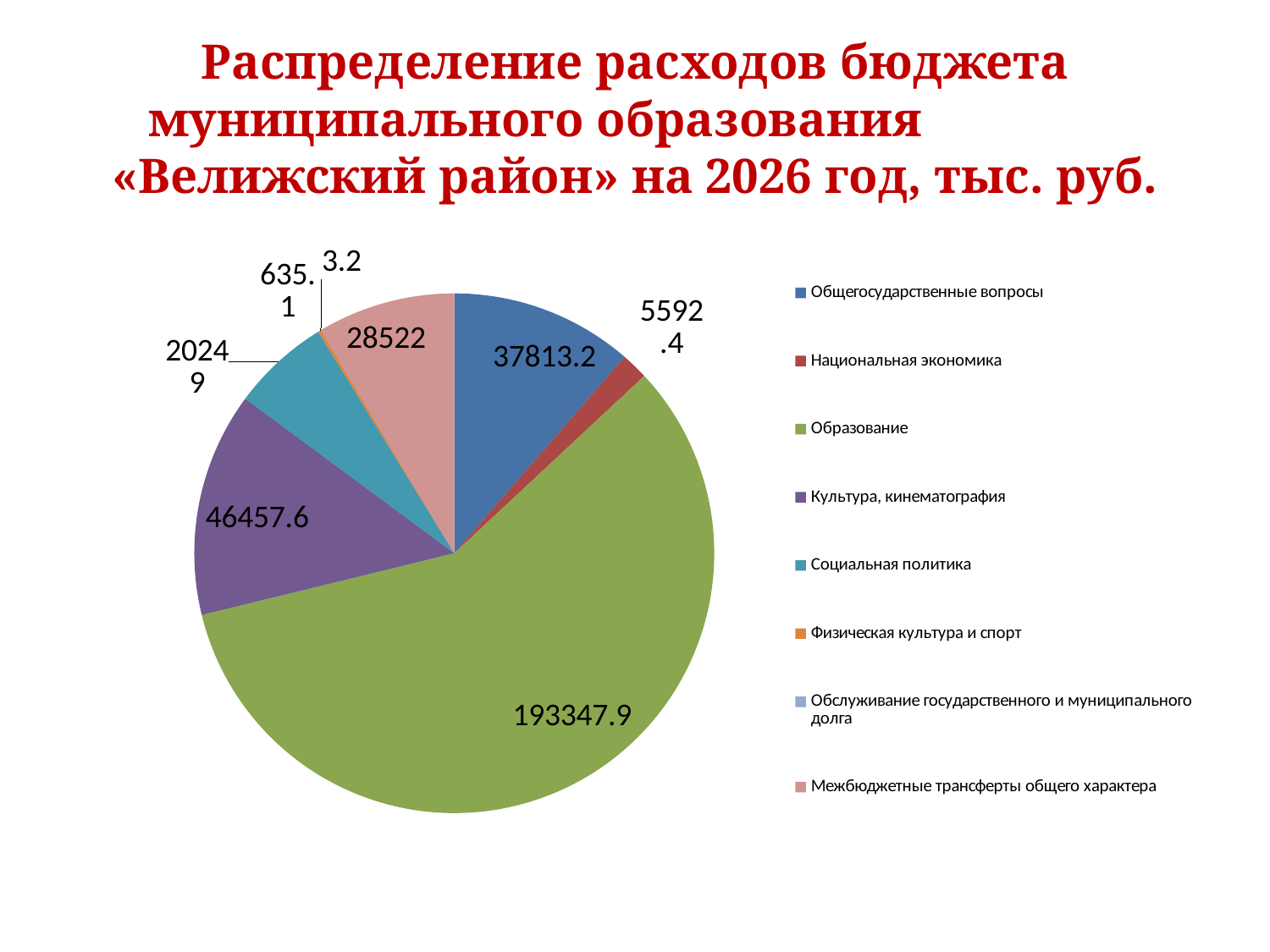
What colour is the slice for Образование? Green Which is larger: the value for Межбюджетные трансферты общего характера or the value for Социальная политика? Межбюджетные трансферты общего характера What is the value for Культура, кинематография? 46457.6 Which category has the largest slice of the pie? Образование What is the value for Межбюджетные трансферты общего характера? 28522 What is the value for Общегосударственные вопросы? 37813.2 What is the value for Физическая культура и спорт? 635.1 What is the value for Образование? 193347.9 What is the difference between the values for Культура, кинематография and Общегосударственные вопросы? 8644.4 Which category has the smallest value? Обслуживание государственного и муниципального долга How many categories does the pie chart show? 8 What kind of chart is shown on the slide? Pie chart